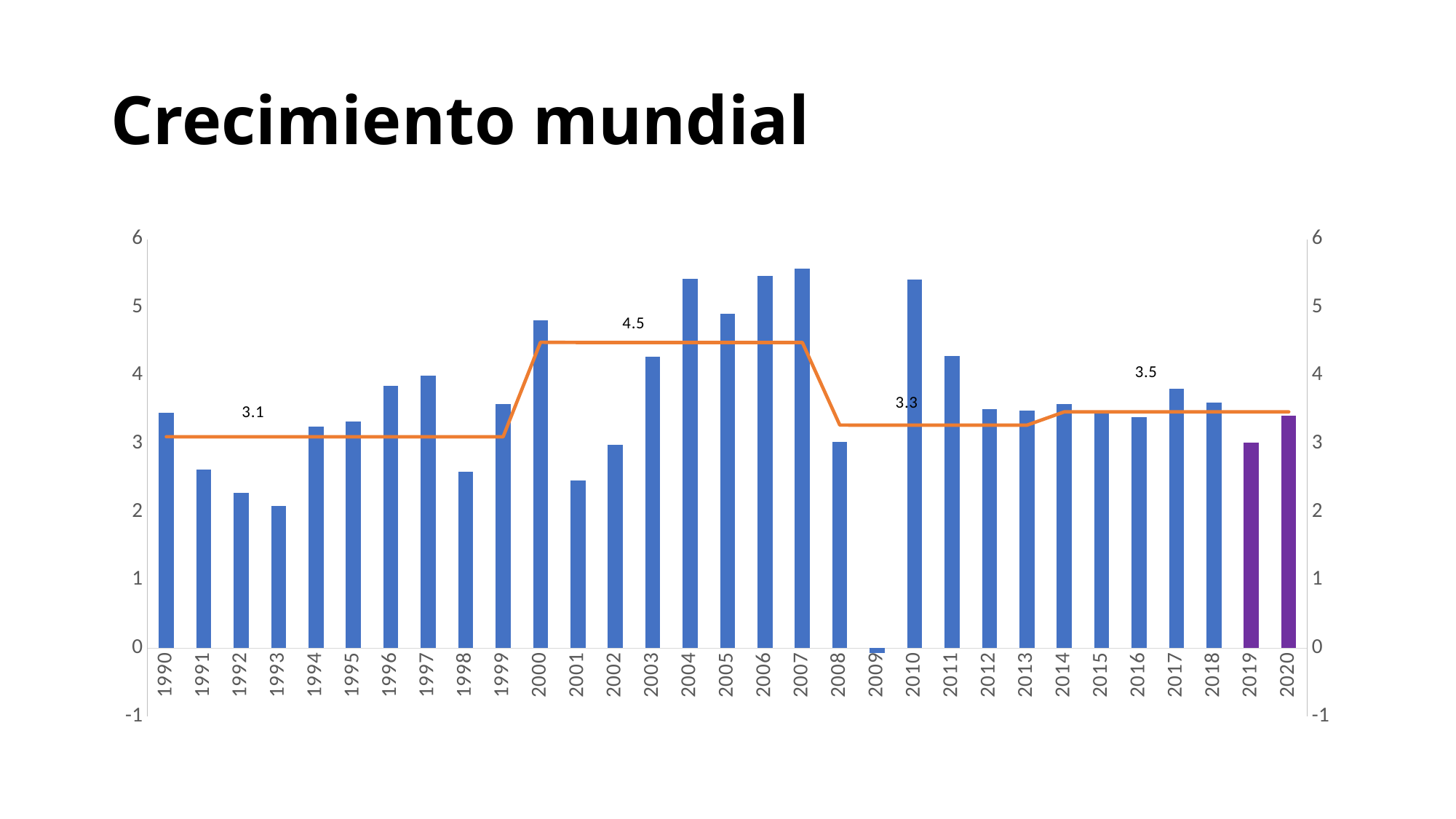
What value is labelled on the orange line for the period starting in 2014? 3.5 Which years are shown with purple bars instead of blue? 2019 and 2020 What value is labelled on the orange line for the period starting in 1990? 3.1 How many years are shown on the x axis of the chart? 31 Which year has the larger bar, 2003 or 2004? 2004 Is the value for 2000 greater or less than 4? greater What is the title of the chart? Crecimiento mundial What kind of chart is shown on the slide? combination bar and line chart What is the difference between the 4.5 and 3.1 values labelled on the orange line? 1.4 What value is labelled on the orange line for the 2000–2007 period? 4.5 Is the value for 1993 greater or less than 3? less Which year has the lowest bar in the chart? 2009